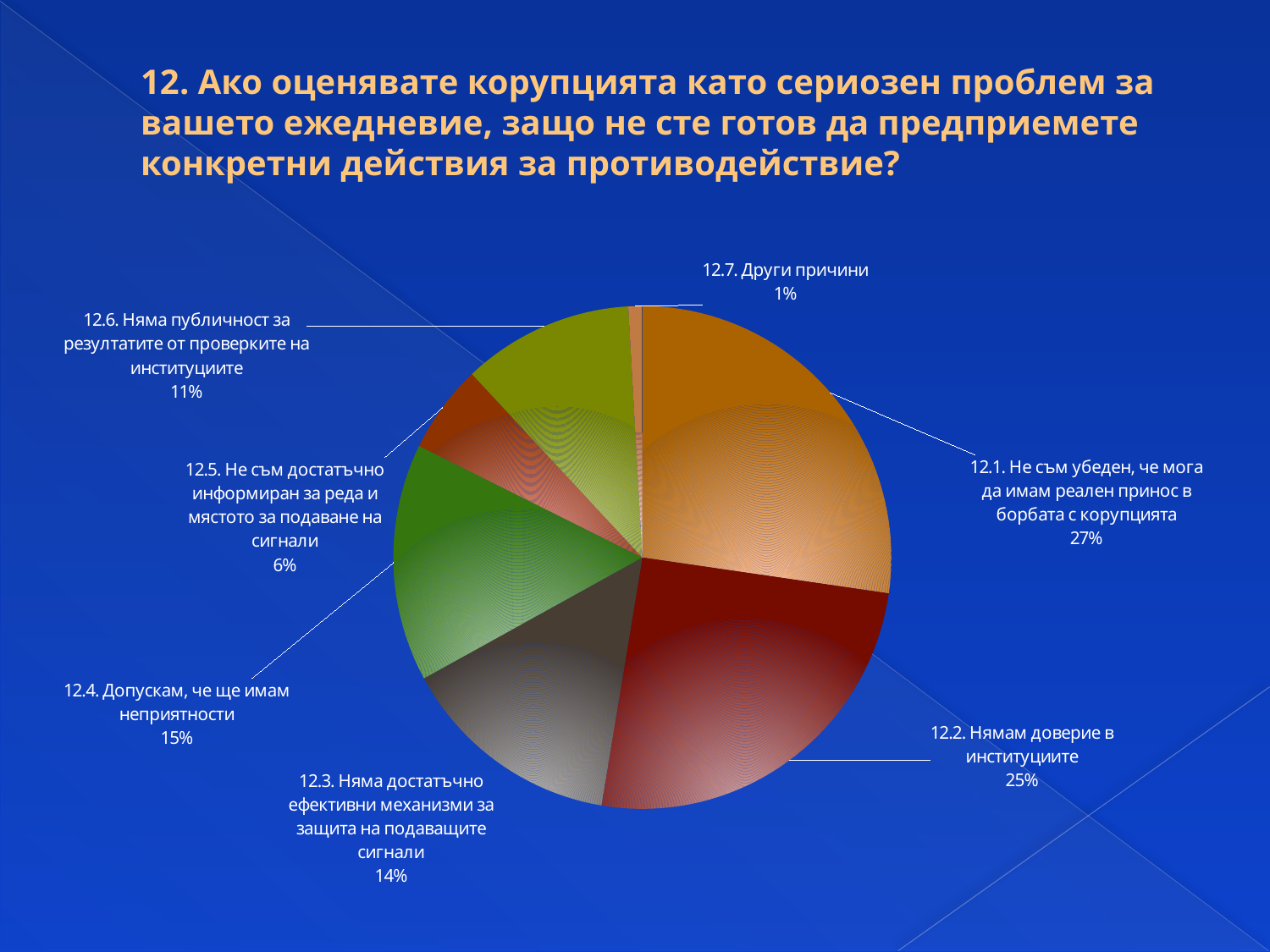
What kind of chart is shown on the slide? pie chart Which category has the smallest share of the pie? 12.7. Други причини What percentage is shown for "12.2. Нямам доверие в институциите"? 25% Which category has the largest share of the pie? 12.1. Не съм убеден, че мога да имам реален принос в борбата с корупцията What is the number of the survey question shown in the chart title? 12 What percentage is shown for "12.1. Не съм убеден, че мога да имам реален принос в борбата с корупцията"? 27% Which is larger: the share for "12.4. Допускам, че ще имам неприятности" or for "12.3. Няма достатъчно ефективни механизми за защита на подаващите сигнали"? 12.4. Допускам, че ще имам неприятности What percentage is shown for "12.6. Няма публичност за резултатите от проверките на институциите"? 11% How many slices does the pie chart have? 7 What is the combined share of "12.5. Не съм достатъчно информиран за реда и мястото за подаване на сигнали" and "12.6. Няма публичност за резултатите от проверките на институциите"? 17% What percentage is shown for "12.4. Допускам, че ще имам неприятности"? 15% What is the difference in percentage points between "12.1. Не съм убеден, че мога да имам реален принос в борбата с корупцията" and "12.2. Нямам доверие в институциите"? 2